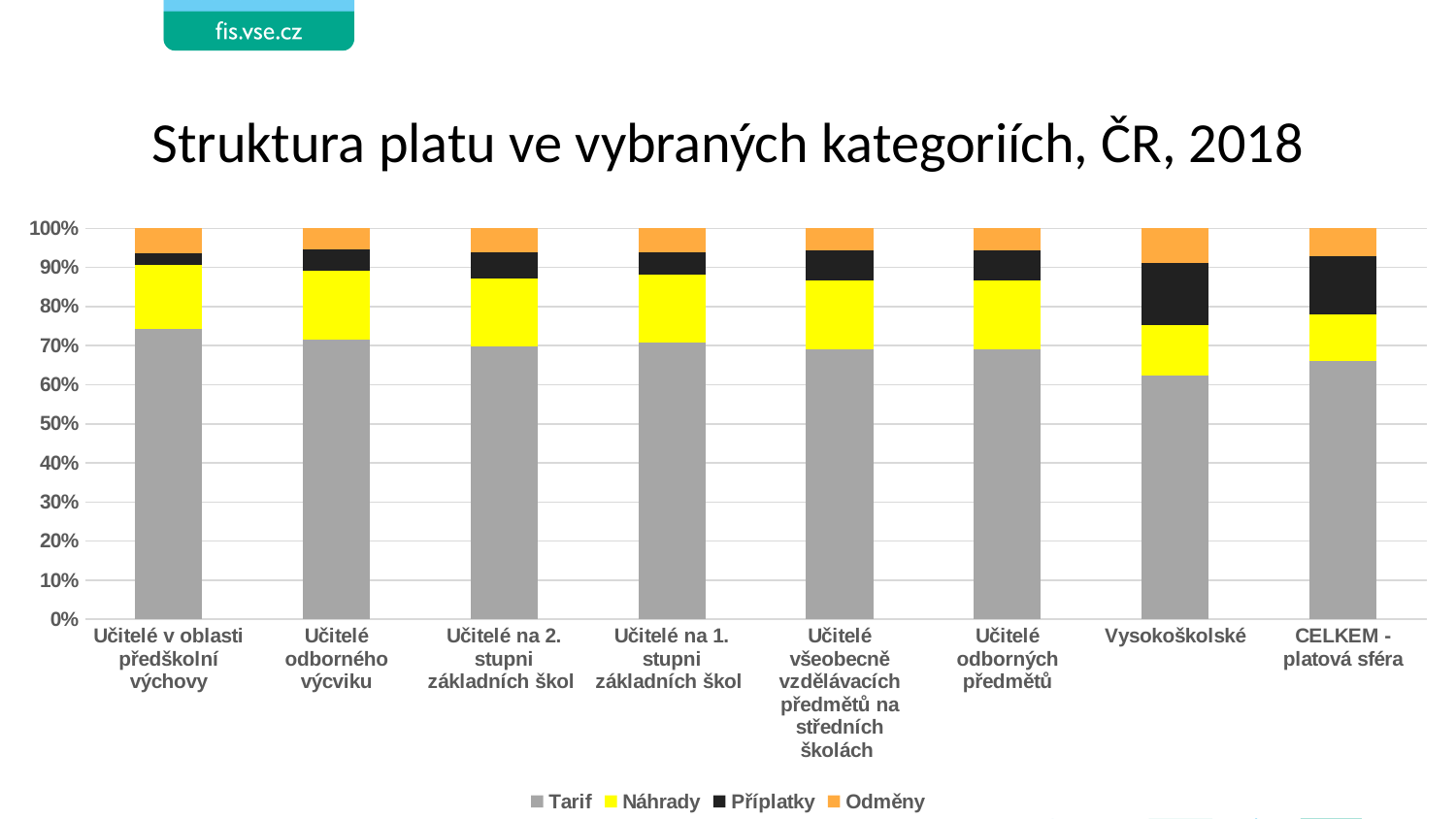
Which category has the highest Tarif share? Učitelé v oblasti předškolní výchovy What is the total of the stacked bar for Vysokoškolské? 100% Which has the larger Tarif share, Vysokoškolské or CELKEM - platová sféra? CELKEM - platová sféra What kind of chart is shown on the slide? Stacked bar chart How many series does the legend list? 4 Is the Tarif share for Učitelé v oblasti předškolní výchovy greater or less than 70%? greater Which series is shown in grey in the chart? Tarif What is the title of the chart? Struktura platu ve vybraných kategoriích, ČR, 2018 Which category has the lowest Tarif share? Vysokoškolské How many categories are shown along the x axis of the chart? 8 Is the Tarif share for CELKEM - platová sféra greater or less than 70%? less Is the Tarif share for Vysokoškolské greater or less than 70%? less